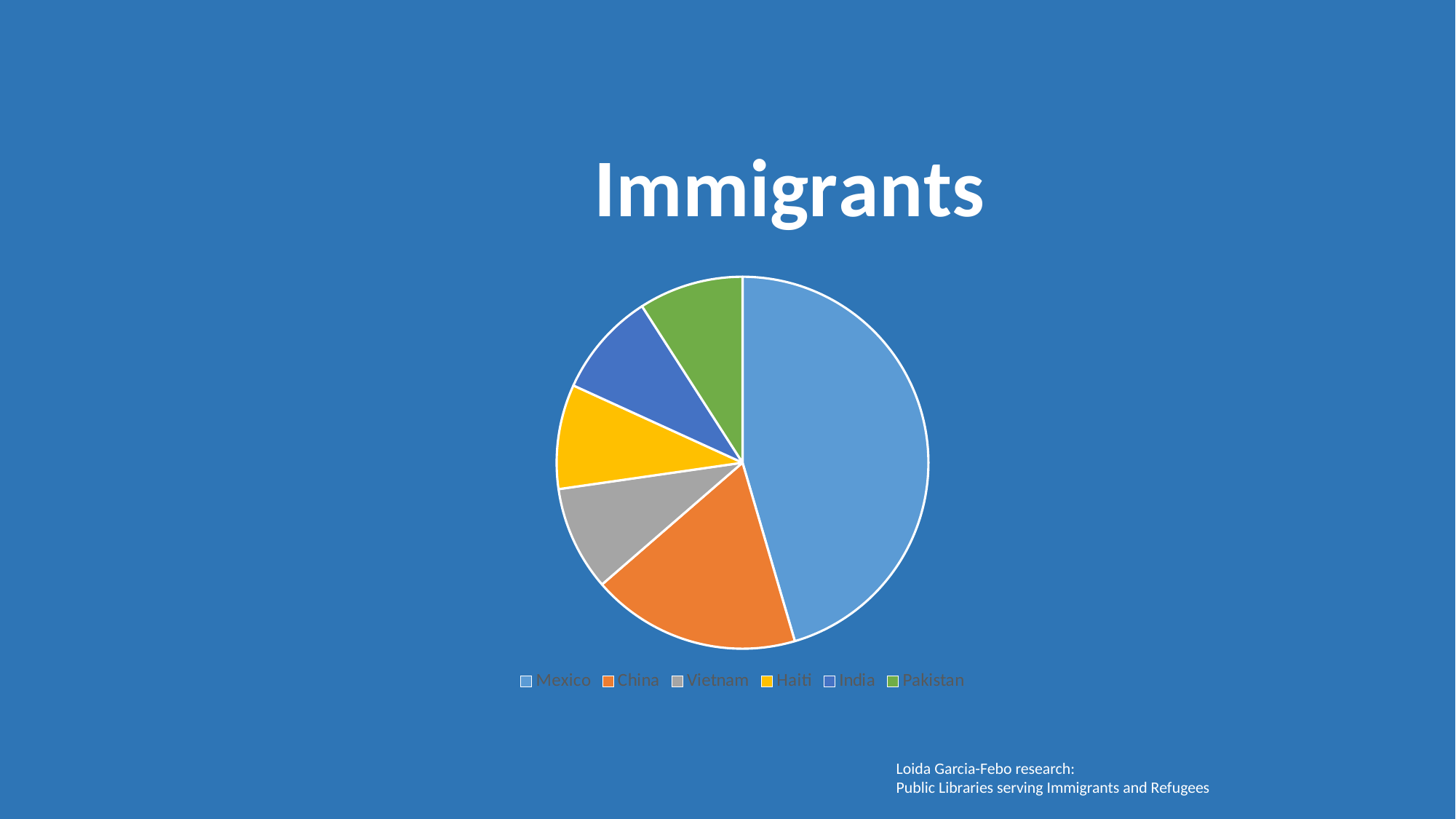
Which slice is larger, China or Vietnam? China What kind of chart is shown on the slide? pie chart Which slice is larger, Pakistan or Mexico? Mexico Which slice is larger, Mexico or China? Mexico Which country is represented by the orange slice? China Which country has the largest slice of the pie chart? Mexico What is the title of the chart? Immigrants How many categories (slices) does the pie chart have? 6